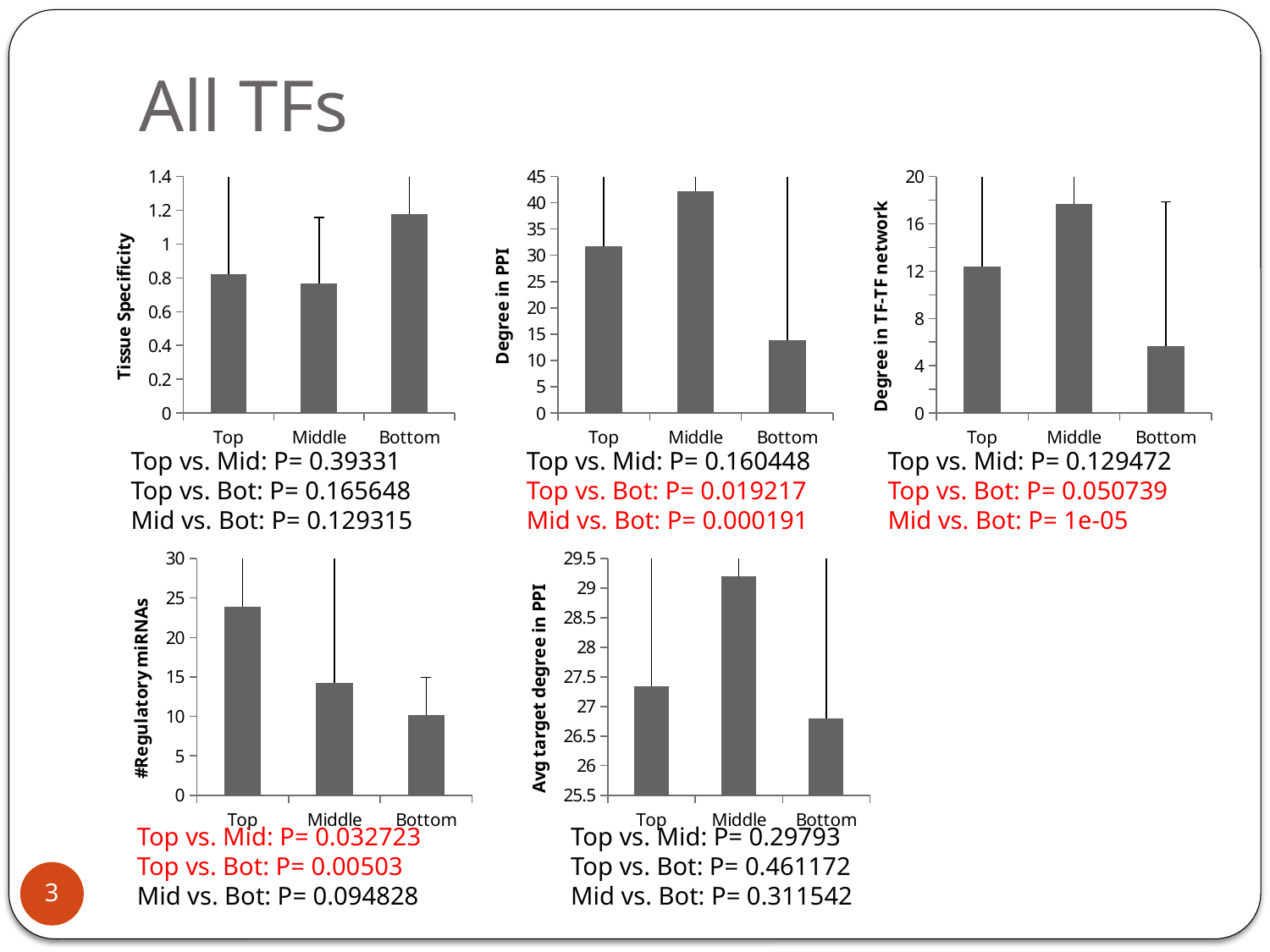
In the Tissue Specificity chart, which category has the highest value? Bottom In the Avg target degree in PPI chart, which is larger, Middle or Bottom? Middle In the #Regulatory miRNAs chart, is the value for Top greater or less than 20? greater How many charts are shown on the slide? 5 In the #Regulatory miRNAs chart, do the values rise or fall from Top to Bottom? fall In the Degree in TF-TF network chart, is the value for Middle greater or less than 16? greater In the Tissue Specificity chart, is the value for Bottom greater or less than 1? greater In the Degree in PPI chart, which category has the highest value? Middle In the Degree in TF-TF network chart, which category has the lowest value? Bottom In the Degree in PPI chart, which category has the lowest value? Bottom How many categories are shown on the x axis of the Tissue Specificity chart? 3